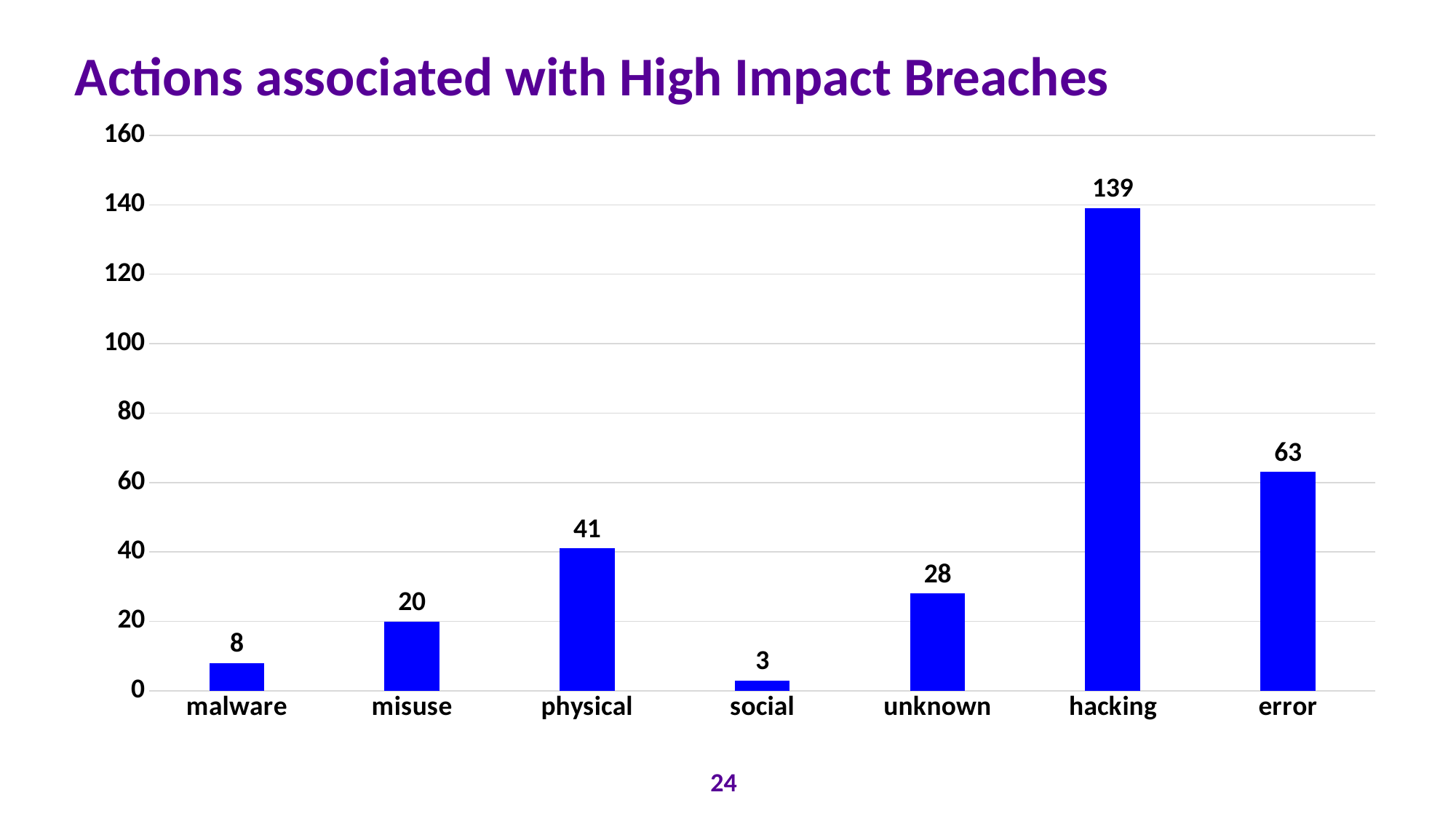
Which category has the highest value? hacking How many categories are shown on the x axis? 7 What is the difference between the values for physical and misuse? 21 Which category has the lowest value? social What is the value for unknown? 28 Which is larger, the value for unknown or the value for misuse? unknown What kind of chart is shown on the slide? bar chart What is the value for hacking? 139 What is the value for physical? 41 What is the title of the chart? Actions associated with High Impact Breaches Is the value for error greater or less than 60? greater What is the difference between the values for hacking and error? 76